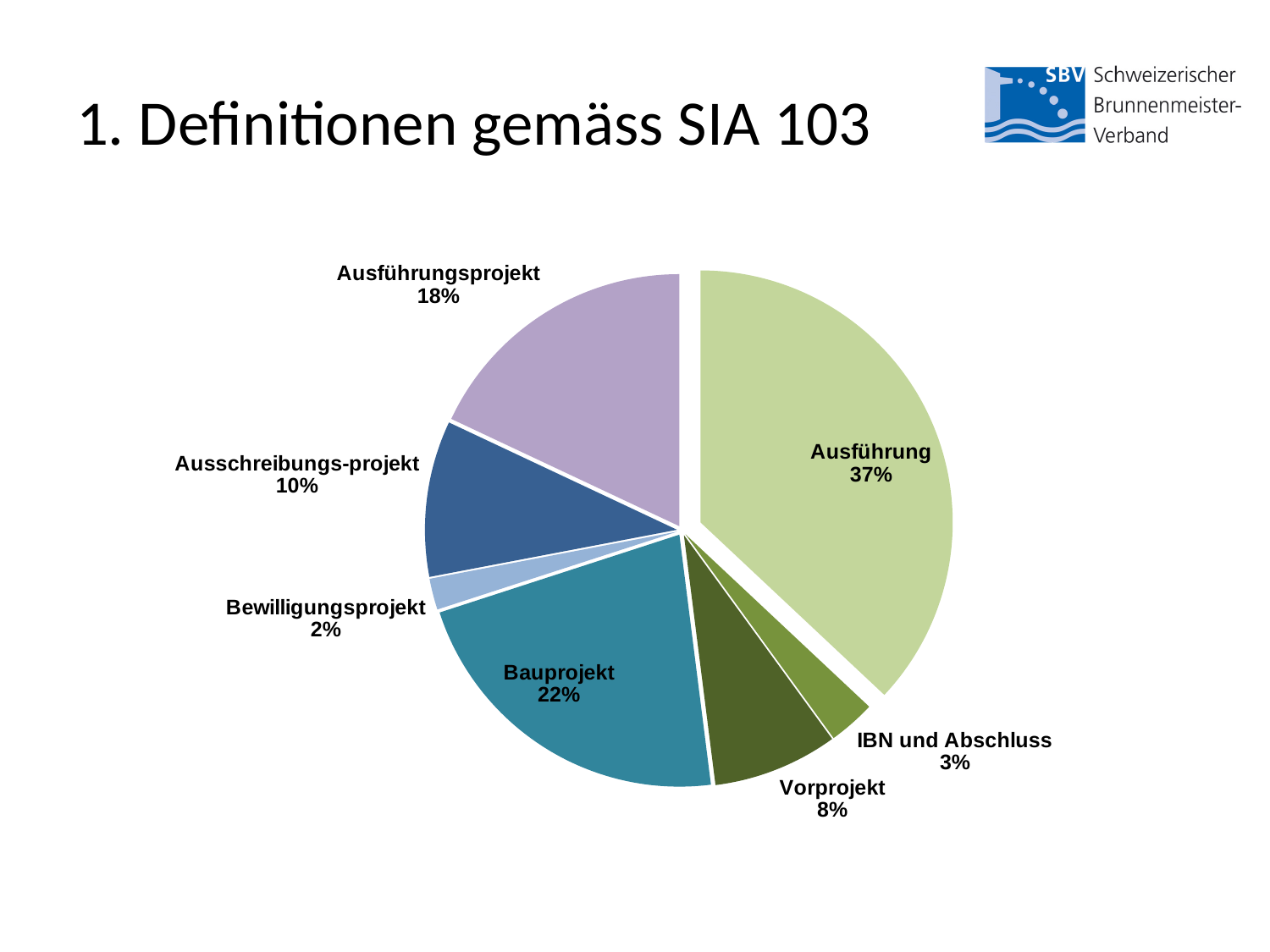
What is the value for Ausführungsprojekt? 18% What is the value for IBN und Abschluss? 3% Which is larger, Ausschreibungs-projekt or Vorprojekt? Ausschreibungs-projekt Which category has the smallest slice of the pie? Bewilligungsprojekt What kind of chart is shown on the slide? pie chart Which category has the largest slice of the pie? Ausführung What is the title of the slide containing the pie chart? 1. Definitionen gemäss SIA 103 What is the difference between the shares of Ausführung and Bauprojekt? 15% How many slices does the pie chart have? 7 What is the value for Bauprojekt? 22% What is the value for Vorprojekt? 8% What share of the pie does Ausführung have? 37%